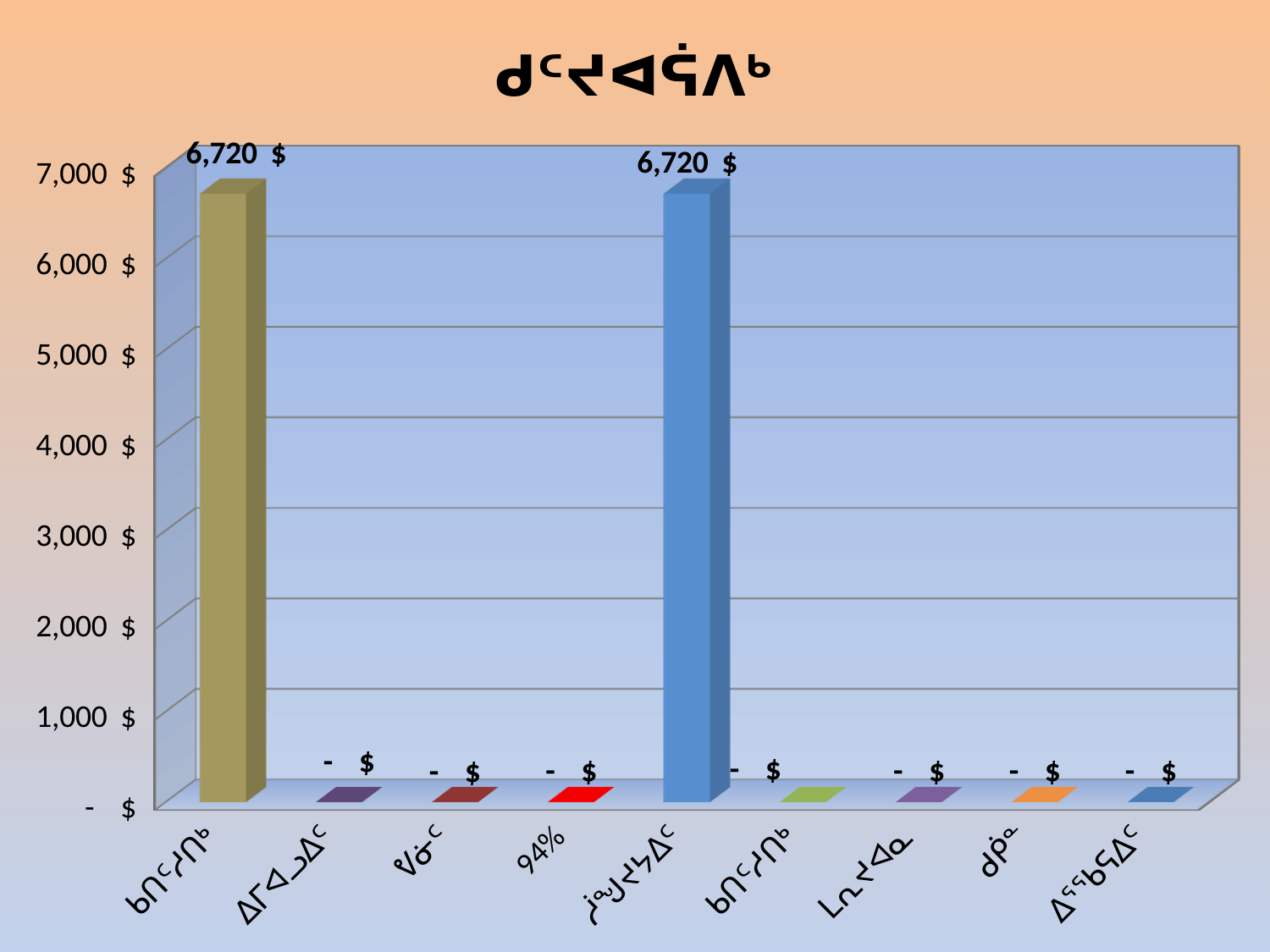
What is the highest value shown on the y axis of the chart? 7,000 $ What is the value of the first (leftmost) bar in the chart? 6,720 $ How many bars in the chart have a non-zero value? 2 What is the difference between the value of the first bar and the value of the fifth bar? 0 $ Is the value of the first bar greater or less than 6,000 $? greater What colour is the first (leftmost) bar in the chart? olive/gold What value is labelled for the category "94%"? - $ What value is labelled for the last (rightmost) category in the chart? - $ Is the value of the fifth bar greater or less than 7,000 $? less What is the value of the fifth bar from the left in the chart? 6,720 $ What kind of chart is shown on the slide? bar chart How many categories are shown along the x axis of the chart? 9